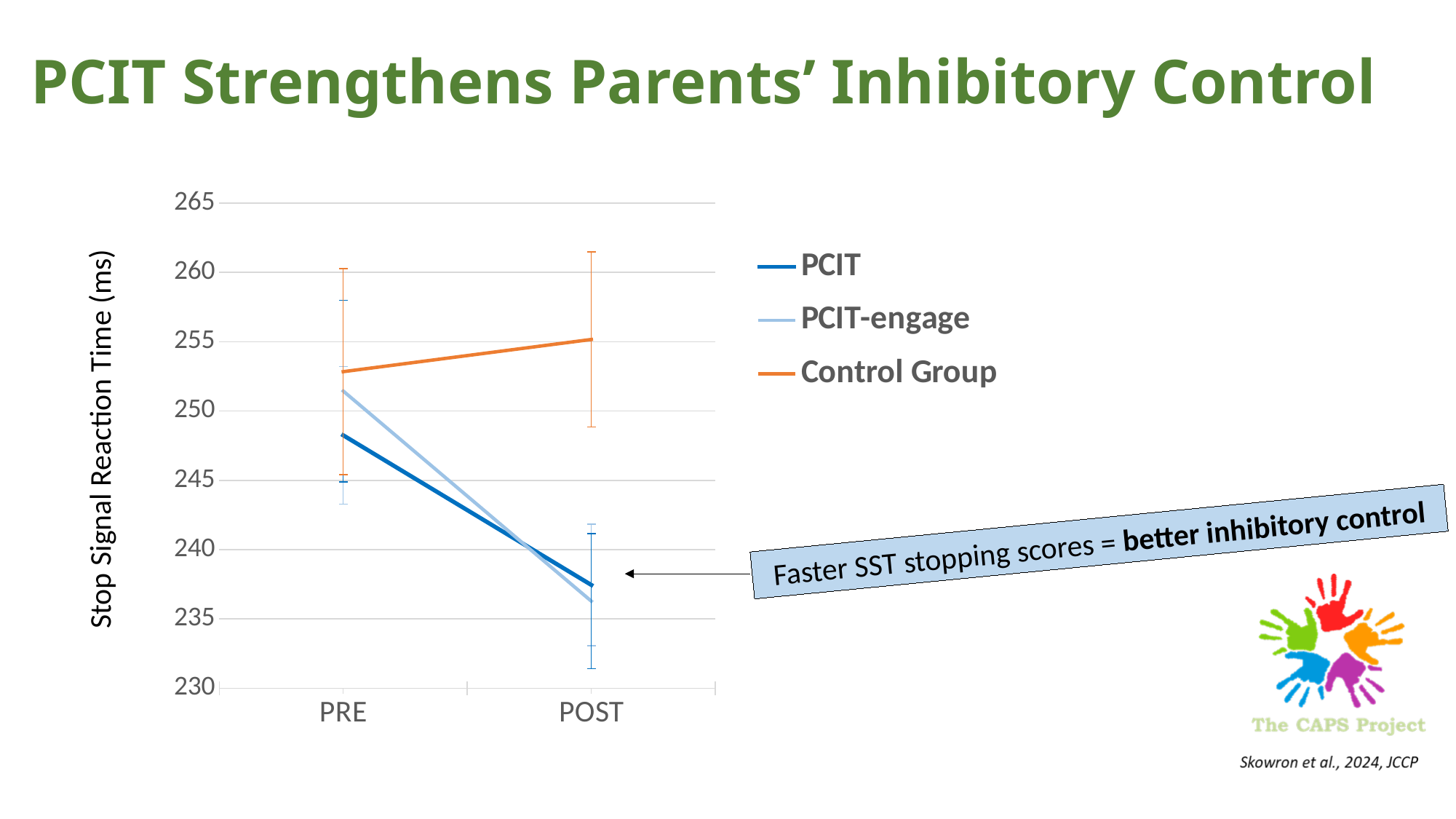
How many time points are shown on the x axis? 2 Is the value for PCIT-engage at POST greater or less than 240? less What is the label of the y axis? Stop Signal Reaction Time (ms) How many series does the legend list? 3 Is the value for Control Group at POST greater or less than 250? greater Does the PCIT line rise or fall from PRE to POST? fall Does the Control Group line rise or fall from PRE to POST? rise Is the value for PCIT at PRE greater or less than 245? greater At PRE, which is larger: the value for Control Group or the value for PCIT? Control Group At POST, which series has the highest Stop Signal Reaction Time? Control Group What kind of chart is shown on the slide? line chart